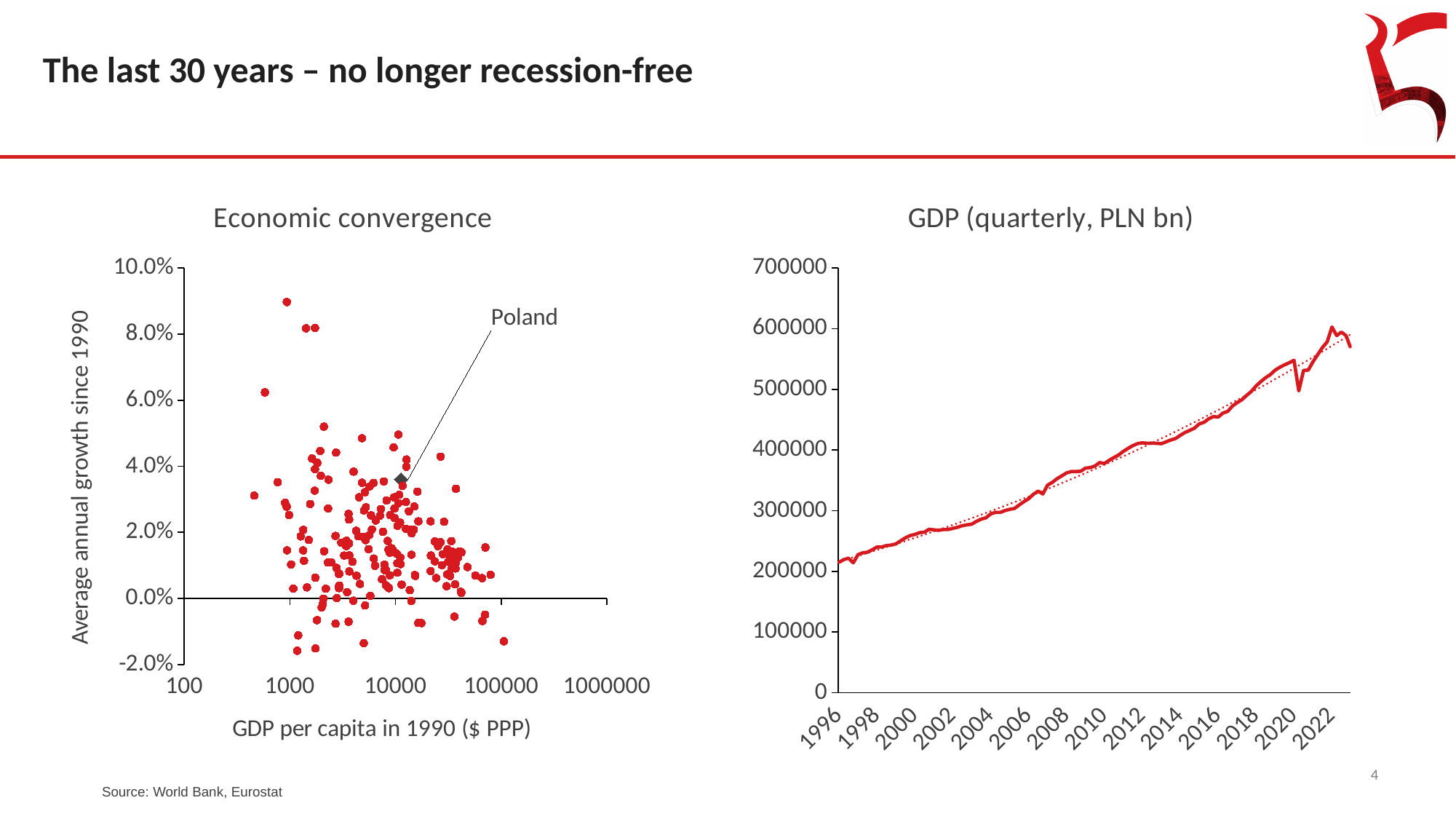
In the 'GDP (quarterly, PLN bn)' chart, is the highest value reached greater or less than 700000? less What kind of chart is the 'Economic convergence' chart? scatter chart In the 'Economic convergence' chart, is Poland's GDP per capita in 1990 greater or less than 100000? less How many year labels are shown on the x axis of the 'GDP (quarterly, PLN bn)' chart? 14 In the 'Economic convergence' chart, is the average annual growth for Poland greater or less than 2.0%? greater In the 'GDP (quarterly, PLN bn)' chart, do the values generally rise or fall from 1996 to 2022? rise What is the x-axis title of the 'Economic convergence' chart? GDP per capita in 1990 ($ PPP) What is the y-axis title of the 'Economic convergence' chart? Average annual growth since 1990 What kind of chart is the 'GDP (quarterly, PLN bn)' chart? line chart